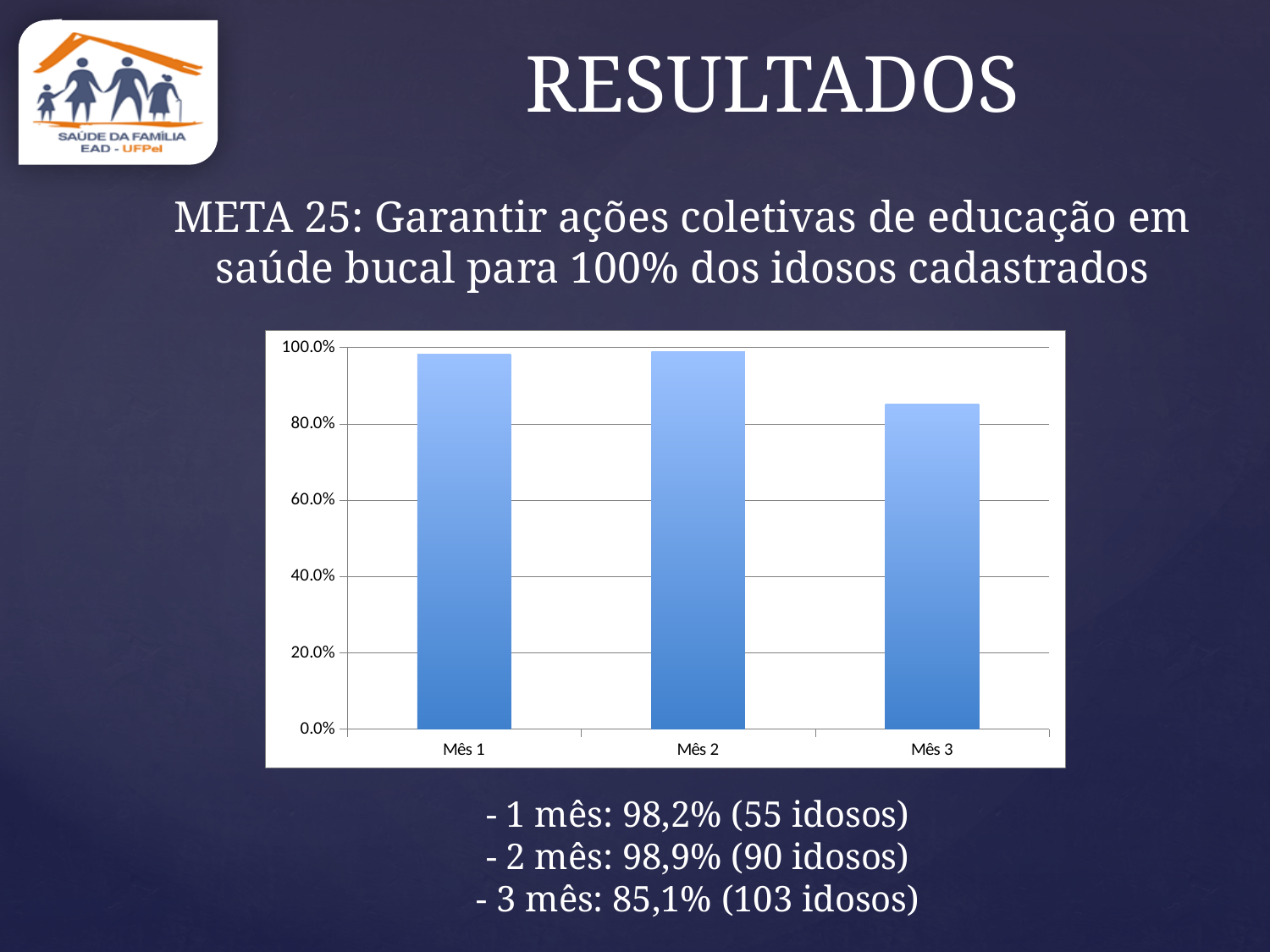
According to the text below the chart, what percentage was reached in the first month (1 mês)? 98,2% According to the text below the chart, how many idosos were covered in the second month (2 mês)? 90 idosos Which is larger, the value for Mês 1 or the value for Mês 3? Mês 1 Is the bar for Mês 1 greater or less than 80.0%? greater How many categories (months) are shown on the x axis of the chart? 3 Which month has the lowest bar in the chart? Mês 3 Is the bar for Mês 3 greater or less than 80.0%? greater Which is larger, the value for Mês 2 or the value for Mês 3? Mês 2 Is the bar for Mês 3 greater or less than 100.0%? less What kind of chart is shown on the slide? bar chart According to the text below the chart, what percentage was reached in the third month (3 mês)? 85,1% What is the highest value shown on the y axis of the chart? 100.0%